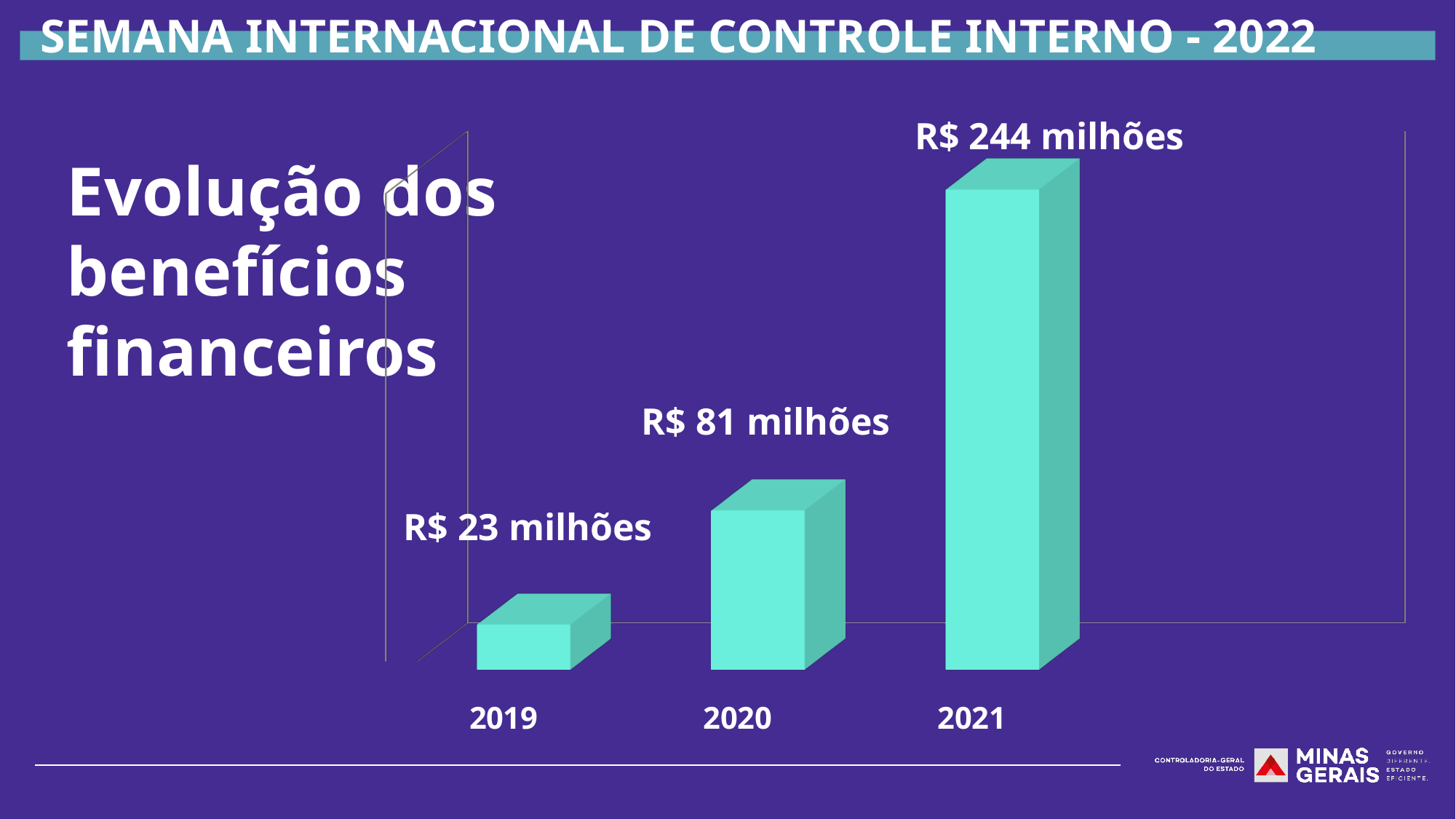
What is the difference between the values for 2020 and 2019? R$ 58 milhões What kind of chart is shown on the slide? Bar chart How many years are shown on the chart? 3 Which year has the highest value? 2021 Which year has the lowest value? 2019 What is the difference between the values for 2021 and 2020? R$ 163 milhões Which is larger, the value for 2020 or the value for 2019? 2020 What is the value for 2019? R$ 23 milhões Do the values rise or fall from 2019 to 2021? Rise What is the value for 2020? R$ 81 milhões What is the value for 2021? R$ 244 milhões What is the title of the chart? Evolução dos benefícios financeiros